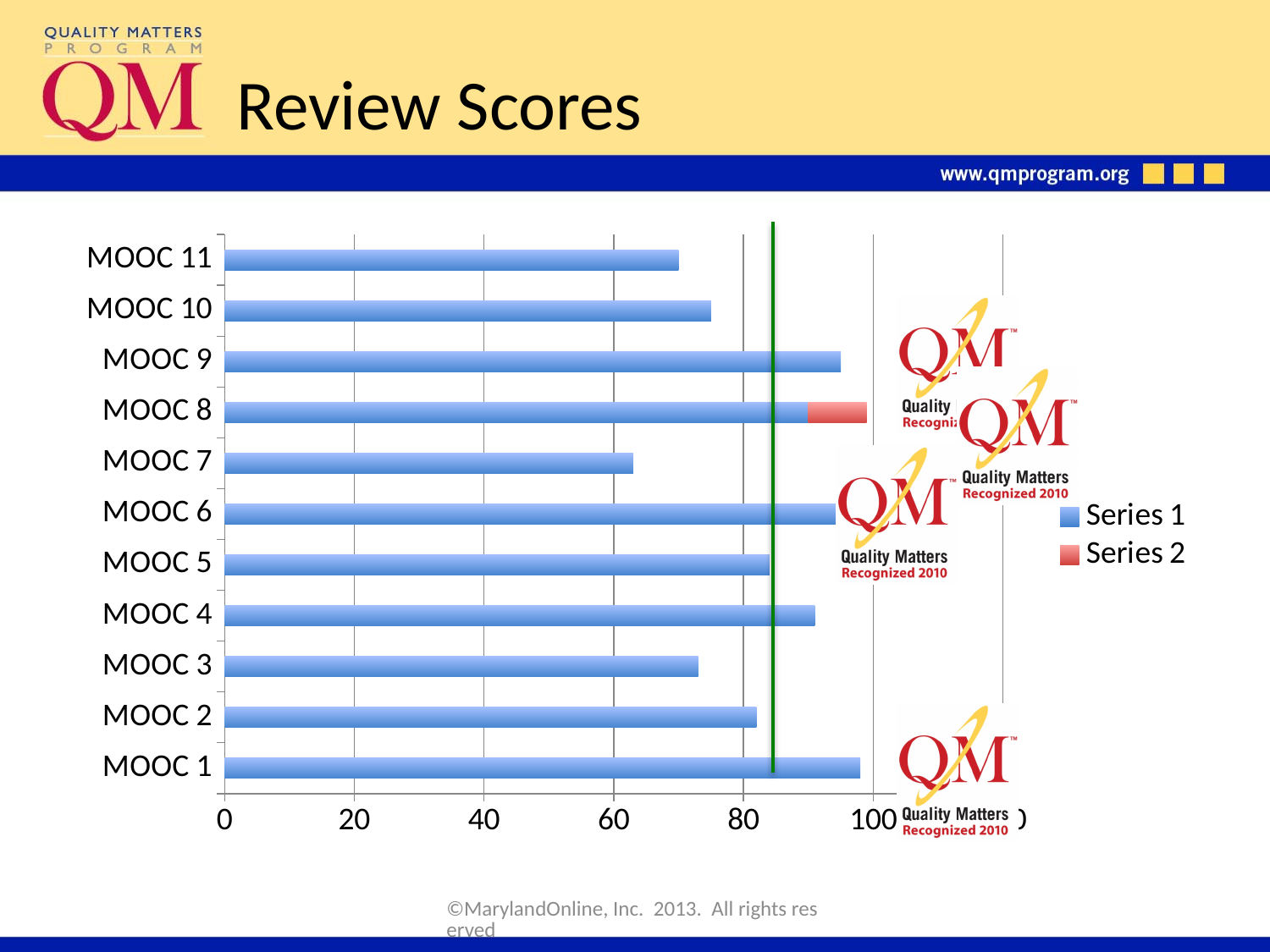
How many MOOC categories are plotted on the chart? 11 Which has the larger Series 1 value, MOOC 9 or MOOC 7? MOOC 9 Which MOOC is the only one with a Series 2 segment on its bar? MOOC 8 Is the Series 1 value for MOOC 7 greater or less than 80? less Is the Series 1 value for MOOC 1 greater or less than 80? greater Is the Series 1 value for MOOC 9 greater or less than 80? greater Which MOOC has the lowest Series 1 value? MOOC 7 Which has the larger Series 1 value, MOOC 1 or MOOC 11? MOOC 1 What kind of chart is shown on the slide? bar chart How many series does the chart legend list? 2